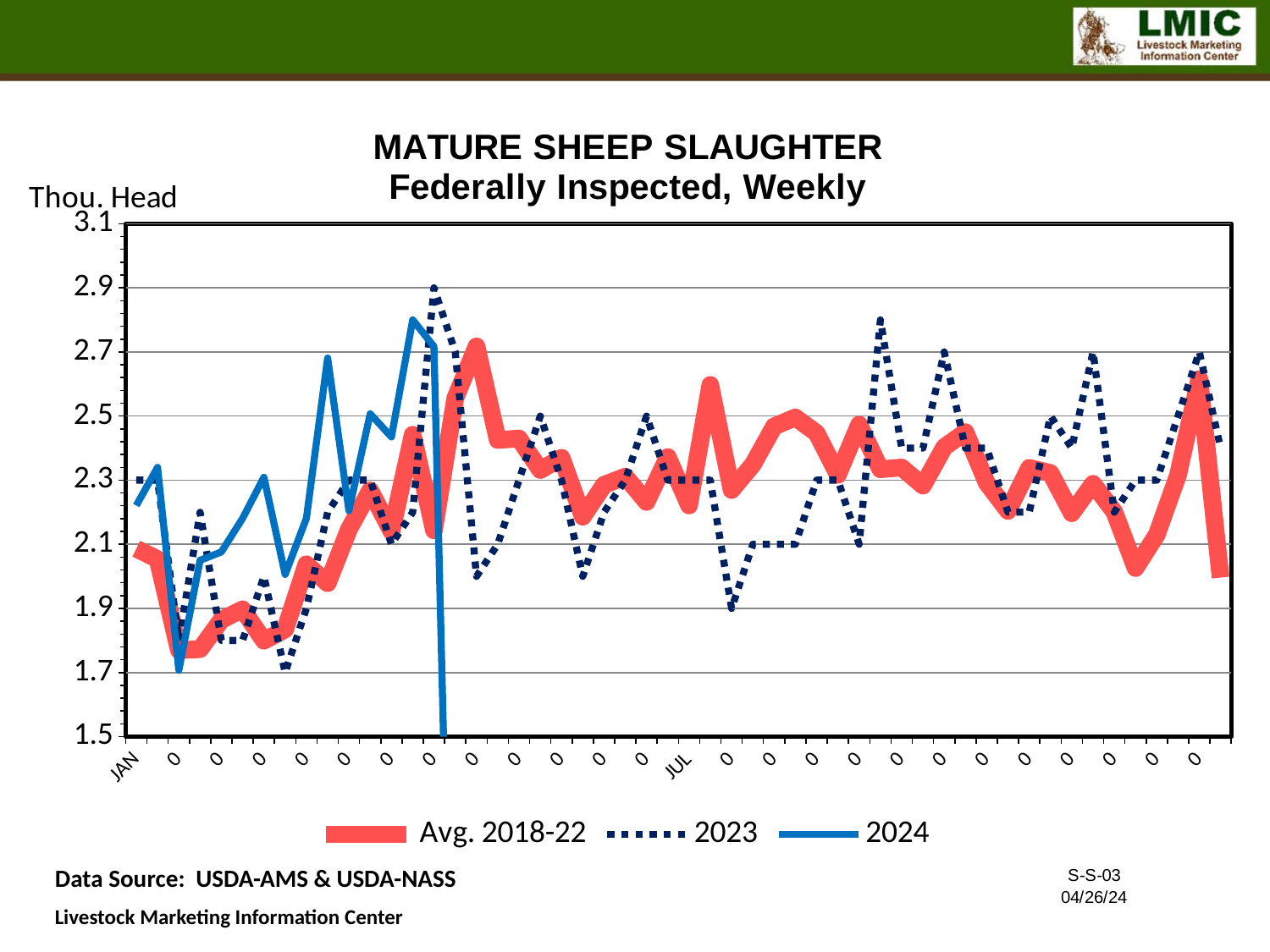
Is the highest value of the 2023 series greater or less than 2.7? greater Is the highest value of the 2024 series greater or less than 2.5? greater What kind of chart is shown on the slide? line chart What is the title of the chart? MATURE SHEEP SLAUGHTER Federally Inspected, Weekly What unit is shown on the y axis of the chart? Thou. Head Is the value of the Avg. 2018-22 series at JAN greater or less than 1.9? greater Does the 2024 series overall rise or fall from JAN to its last plotted point? rise Which series is plotted for only the first part of the year? 2024 Which series reaches the highest peak on the chart, 2023 or 2024? 2023 How many series does the legend list? 3